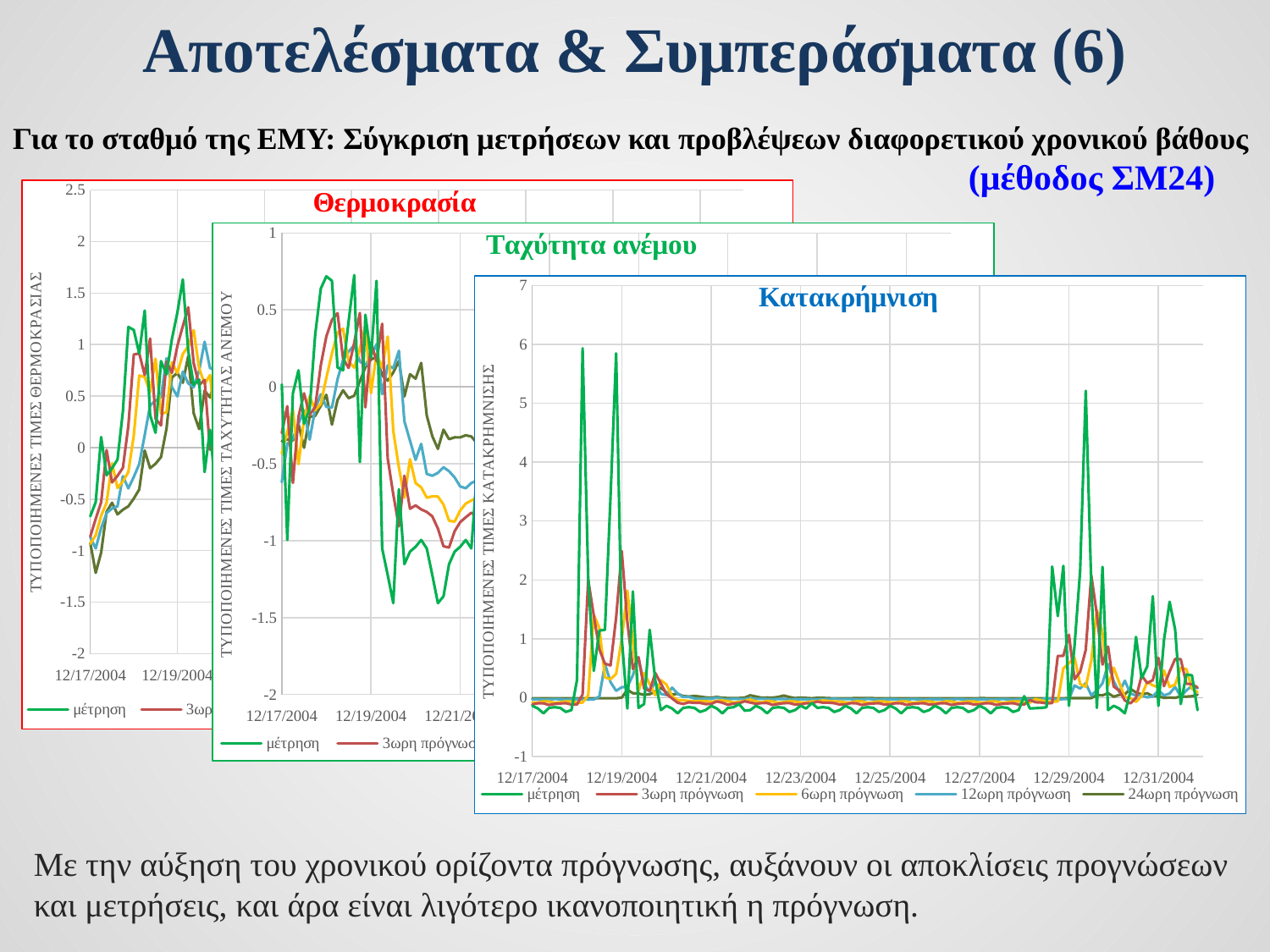
In the Κατακρήμνιση chart, is the peak of the μέτρηση series near 12/30/2004 greater or less than 4? greater In the Θερμοκρασία chart, is the highest value of the μέτρηση series greater or less than 1? greater What is the y-axis label of the Κατακρήμνιση chart? ΤΥΠΟΠΟΙΗΜΕΝΕΣ ΤΙΜΕΣ ΚΑΤΑΚΡΗΜΝΙΣΗΣ In the Κατακρήμνιση chart, is the peak of the 3ωρη πρόγνωση series near 12/19/2004 greater or less than 4? less How many series does the legend of the Κατακρήμνιση chart list? 5 How many charts are shown on the slide? 3 What is the maximum value shown on the y axis of the Κατακρήμνιση chart? 7 In the Κατακρήμνιση chart, which series reaches the highest value overall? μέτρηση In the Κατακρήμνιση chart, which series is drawn in green? μέτρηση What kind of chart is the Κατακρήμνιση chart? line chart